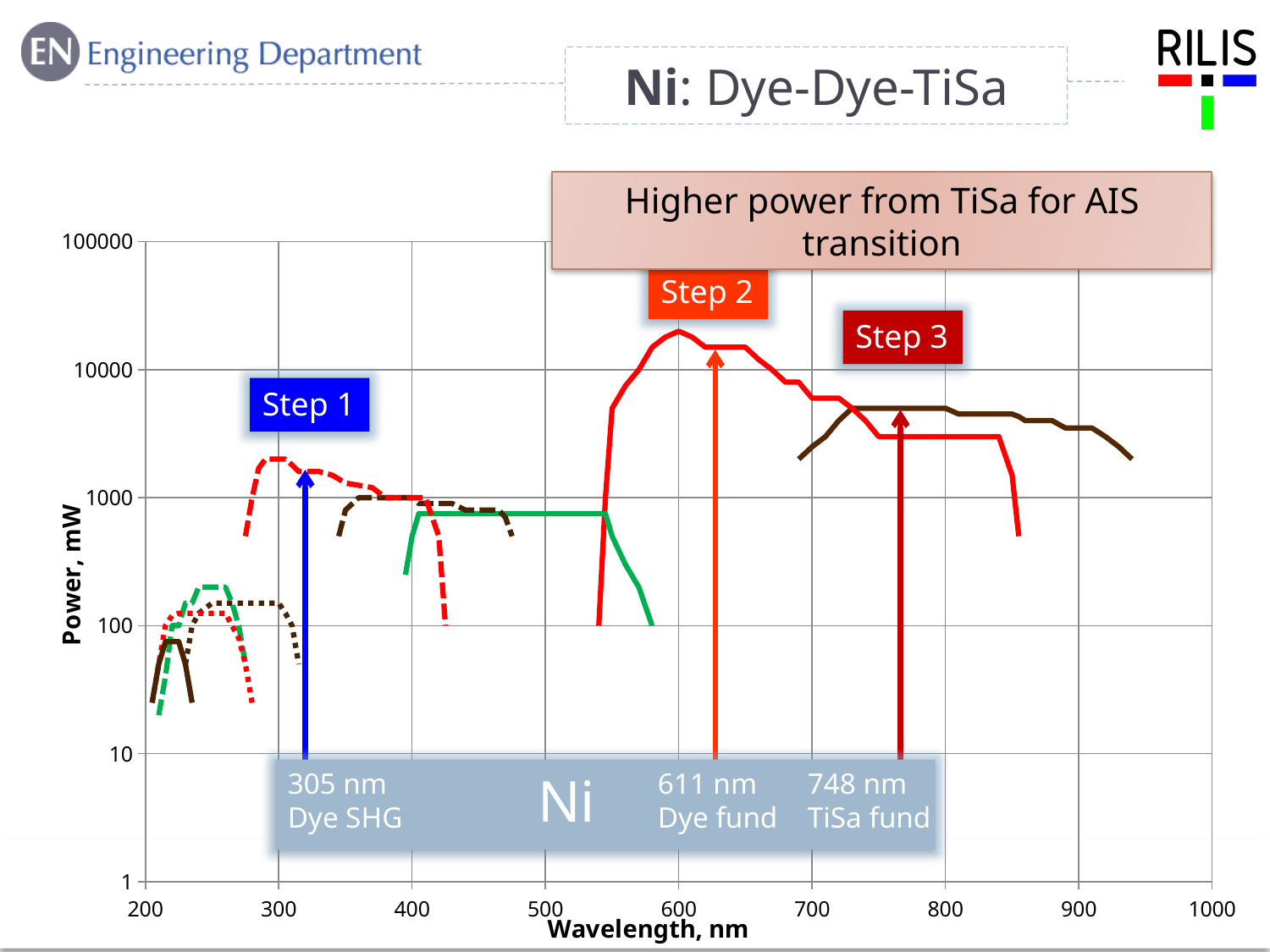
What wavelength is given for Step 1 (Dye SHG)? 305 nm What is the label of the y axis of the chart? Power, mW Which laser type is used for the 748 nm step? TiSa fund How many excitation steps are marked on the chart? 3 Is the power of the solid brown curve at 800 nm greater or less than 10000 mW? less What wavelength is given for Step 3 (TiSa fund)? 748 nm What wavelength is given for Step 2 (Dye fund)? 611 nm Is the power of the solid green curve at 500 nm greater or less than 1000 mW? less Is the peak power of the solid red curve near 600 nm greater or less than 10000 mW? greater Which has the higher peak power: the solid red curve near 600 nm or the solid brown curve near 750 nm? the solid red curve near 600 nm What is the label of the x axis of the chart? Wavelength, nm What kind of chart is shown on the slide? line chart